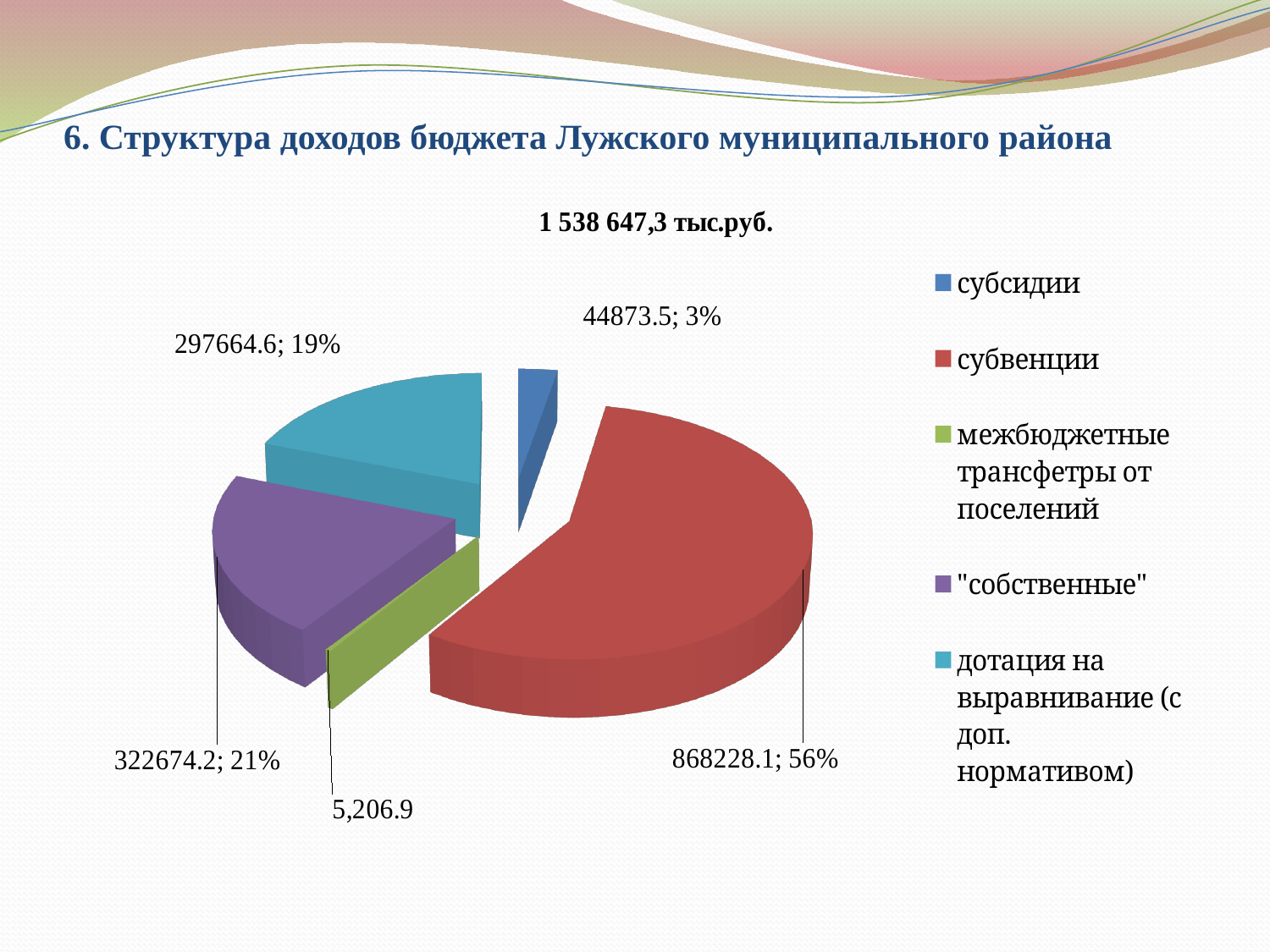
What share of the pie does субвенции take? 56% What is the value for субсидии? 44873.5 What is the value for субвенции? 868228.1 Which category has the largest slice of the pie? субвенции What kind of chart is shown on the slide? pie chart What is the value for "собственные"? 322674.2 Which category has the smallest slice of the pie? межбюджетные трансфетры от поселений How many categories does the legend list? 5 What share of the pie does дотация на выравнивание (с доп. нормативом) take? 19% Which is larger, the value for "собственные" or the value for дотация на выравнивание (с доп. нормативом)? "собственные" What share of the pie does субсидии take? 3% What is the value for межбюджетные трансфетры от поселений? 5,206.9